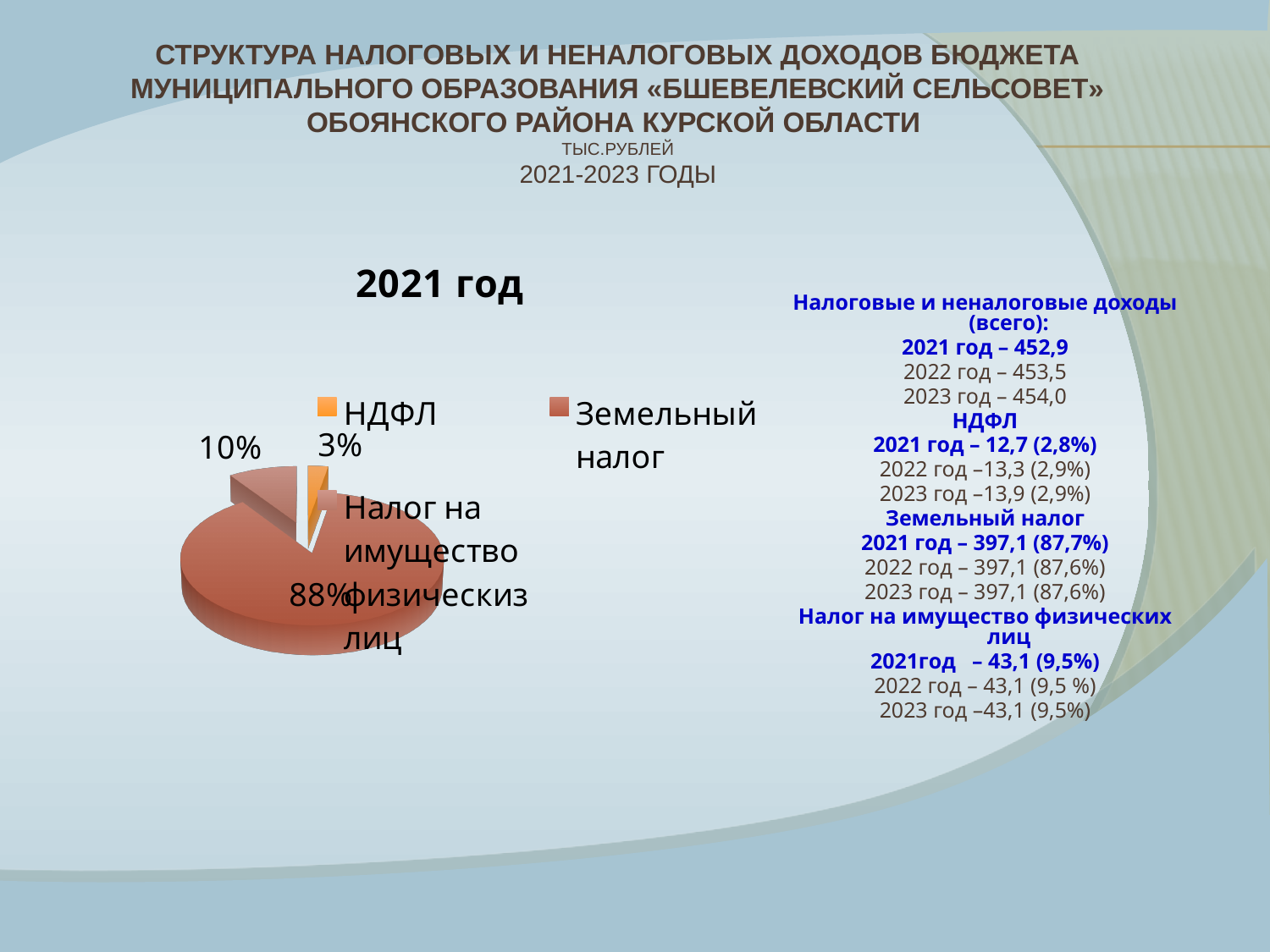
By how many percentage points does the Налог на имущество физических лиц slice exceed the НДФЛ slice? 7 percentage points What is the title of the chart? 2021 год Which category has the largest slice of the pie? Земельный налог What share of the pie does Земельный налог hold? 88% Which slice is larger: НДФЛ or Налог на имущество физических лиц? Налог на имущество физических лиц What percentage is shown for Налог на имущество физических лиц on the pie chart? 10% What type of chart is shown on the slide? Pie chart What percentage is shown for НДФЛ on the pie chart? 3% Which category has the smallest slice of the pie? НДФЛ How many entries does the chart legend list? 3 How many slices does the pie chart have? 3 By how many percentage points does the Земельный налог slice exceed the Налог на имущество физических лиц slice? 78 percentage points